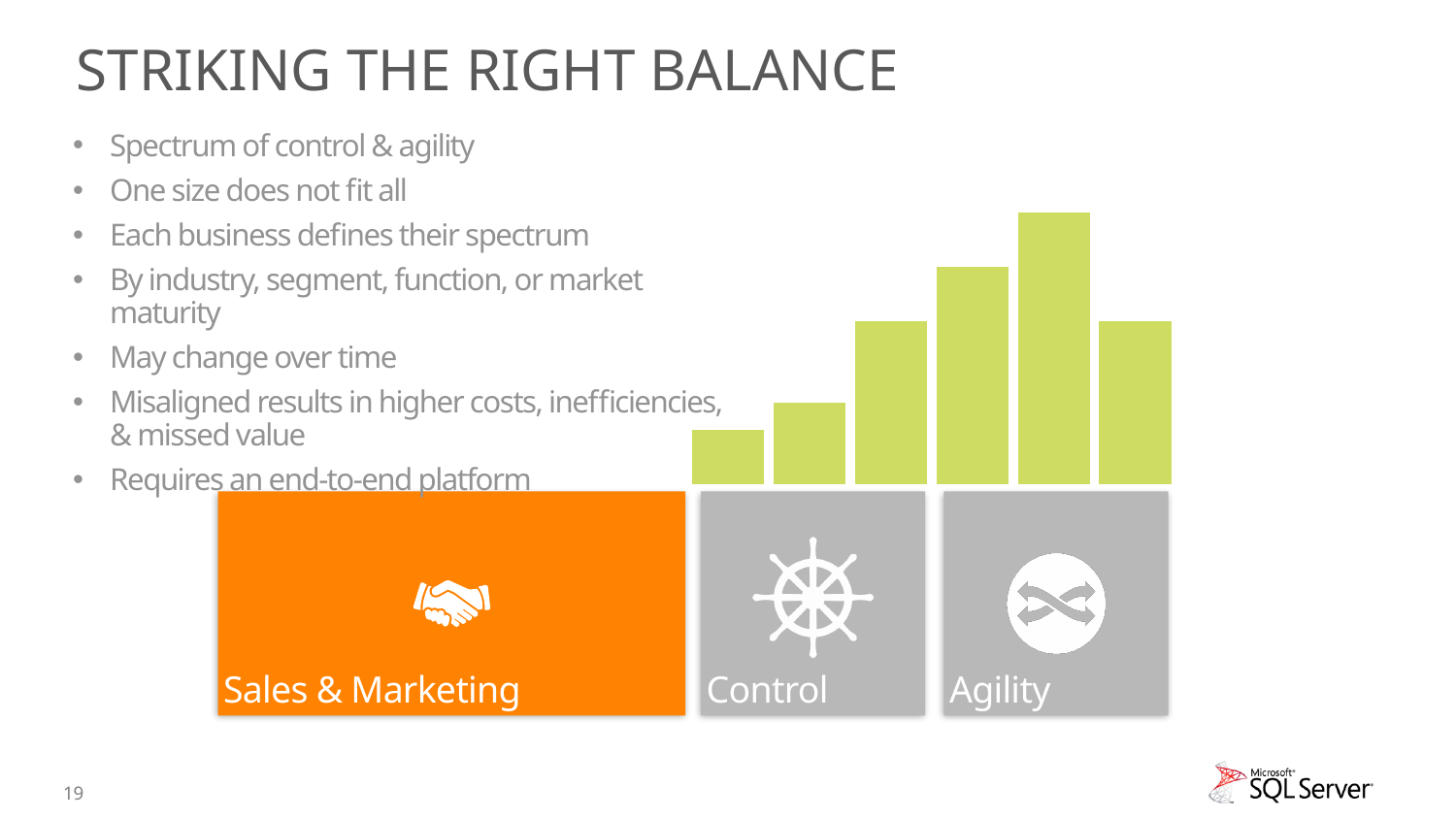
Which bar in the chart is the tallest, counting from the left? the fifth bar How many bars does the chart on the slide contain? 6 What colour are the bars in the chart? green Is the last bar on the right taller or shorter than the fifth bar? shorter What kind of chart is shown on the right side of the slide? bar chart Do the bars rise or fall from the first bar to the fifth bar? rise Is the second bar from the left taller or shorter than the third bar? shorter Which bar in the chart is the shortest, counting from the left? the first bar Does the chart display any data labels or axis values? No